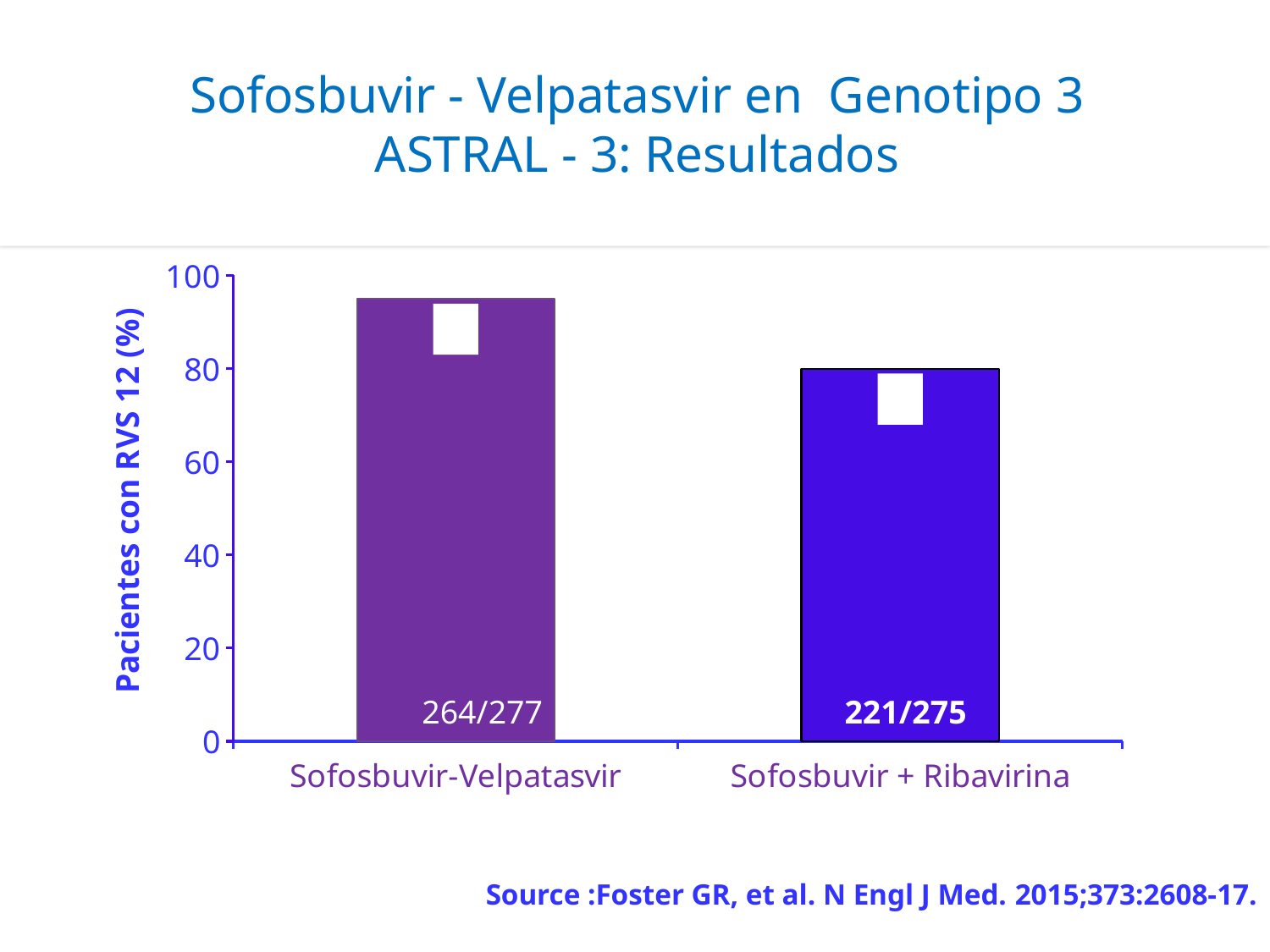
Is the value for Sofosbuvir + Ribavirina greater or less than 60? greater What fraction is printed on the Sofosbuvir + Ribavirina bar? 221/275 How many bars (categories) are plotted in the chart? 2 Do the bar values rise or fall from left to right along the x axis? fall What is the maximum value shown on the y axis? 100 What fraction is printed on the Sofosbuvir-Velpatasvir bar? 264/277 Is the value for Sofosbuvir-Velpatasvir greater or less than 80? greater Which treatment has the lowest percentage of patients with RVS 12? Sofosbuvir + Ribavirina What is the label of the y axis? Pacientes con RVS 12 (%) Which treatment has the highest percentage of patients with RVS 12? Sofosbuvir-Velpatasvir Which bar is taller, Sofosbuvir-Velpatasvir or Sofosbuvir + Ribavirina? Sofosbuvir-Velpatasvir What kind of chart is shown on the slide? bar chart